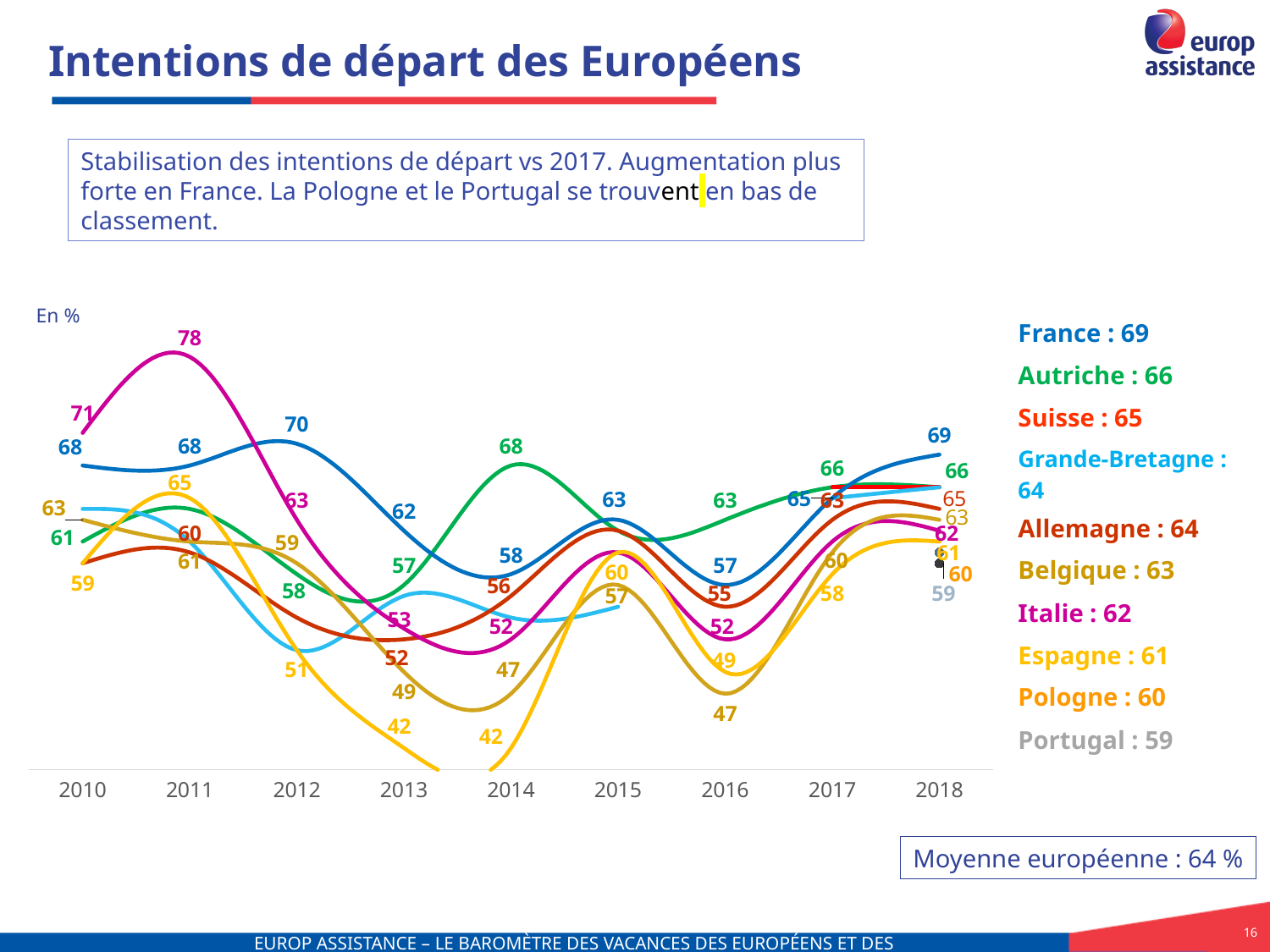
What is the difference between the 2018 values for France and Portugal? 10 Which country has the highest value in 2018? France How many years are shown along the x axis of the chart? 9 Which country has the lowest value in 2018? Portugal Does the value for France rise or fall from 2016 to 2018? rise How many countries are listed in the legend on the right of the chart? 10 What is the value for Portugal in 2018? 59 What is the European average (Moyenne européenne) shown on the slide? 64 % In 2018, which is larger: the value for Autriche or the value for Italie? Autriche What is the value for France in 2018? 69 What kind of chart is shown on the slide? line chart What is the value for France in 2012? 70